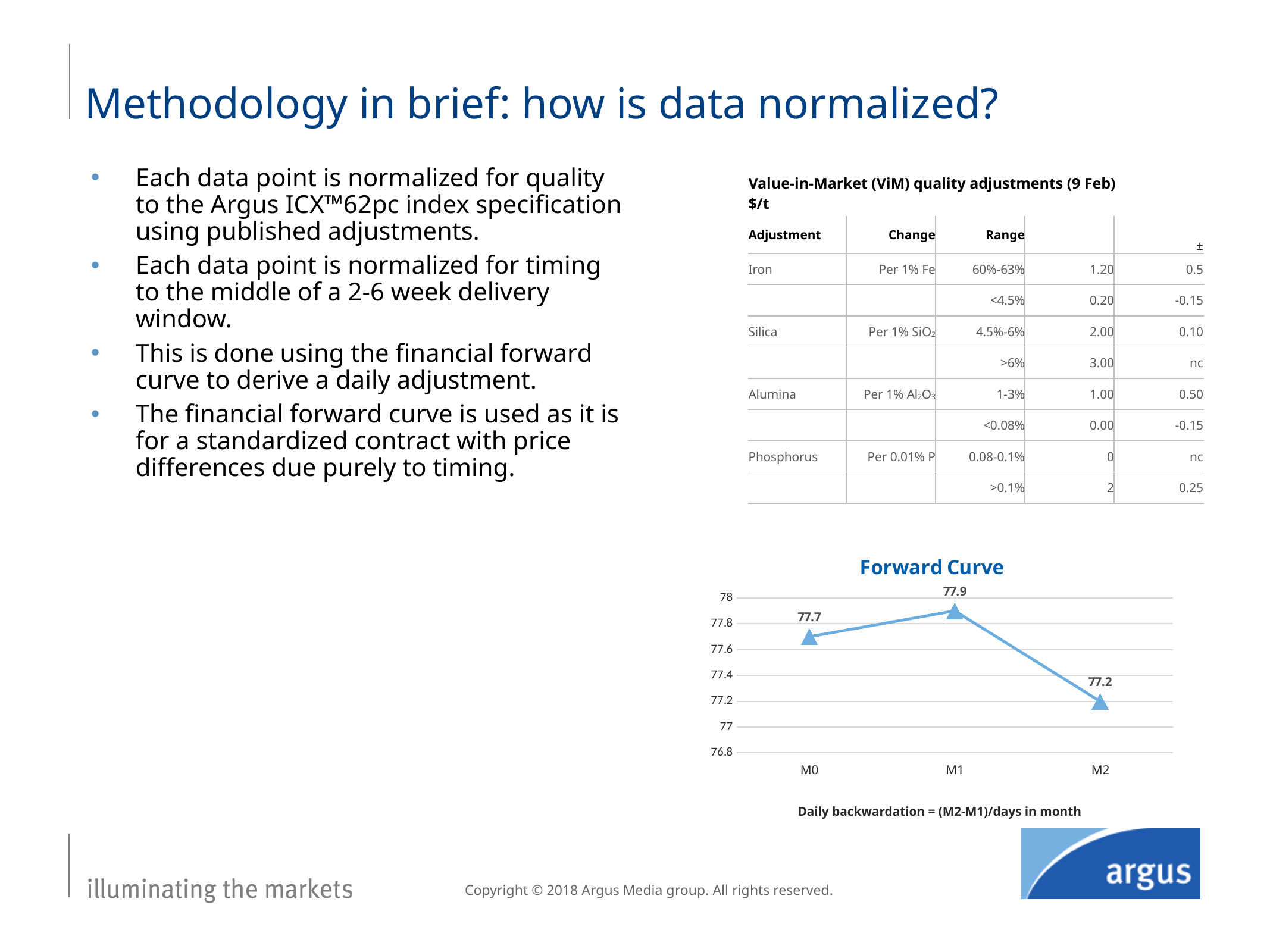
Is the value for M2 in the Forward Curve chart greater or less than 77.4? less In the Forward Curve chart, which is larger, the value for M0 or the value for M2? M0 What is the title of the chart on the slide? Forward Curve What is the difference between the M1 and M0 values in the Forward Curve chart? 0.2 What kind of chart is the Forward Curve chart? line chart What is the value for M1 in the Forward Curve chart? 77.9 How many data points are plotted in the Forward Curve chart? 3 Which point has the lowest value in the Forward Curve chart? M2 What is the difference between the M1 and M2 values in the Forward Curve chart? 0.7 Which point has the highest value in the Forward Curve chart? M1 What is the value for M2 in the Forward Curve chart? 77.2 What is the value for M0 in the Forward Curve chart? 77.7